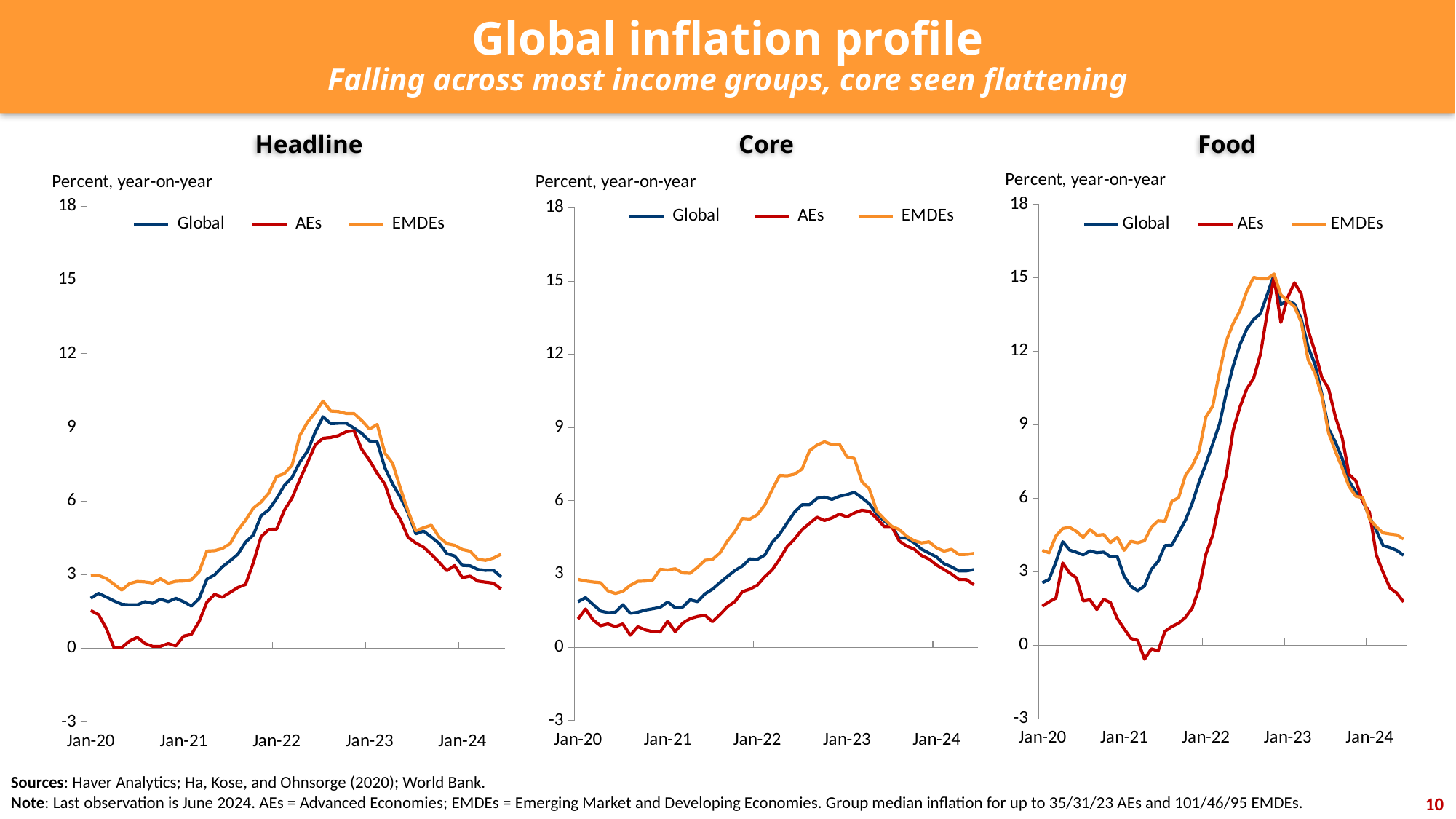
In the Headline chart, does the Global line rise or fall between Jan-23 and Jan-24? fall In the Headline chart, is the peak value of the EMDEs line greater or less than 9? greater What kind of chart is the Headline chart? line chart What label is shown above the y axis of the Headline chart? Percent, year-on-year How many series does the legend of the Core chart list? 3 In the Core chart, is the peak value of the EMDEs line greater or less than 9? less In the Headline chart, which series reaches the highest peak? EMDEs Which series are listed in the legend of the Food chart? Global, AEs, EMDEs How many charts are shown on the slide? 3 In the Food chart, is the lowest value of the AEs line greater or less than 0? less In the Headline chart, which series is lowest at Jan-20? AEs